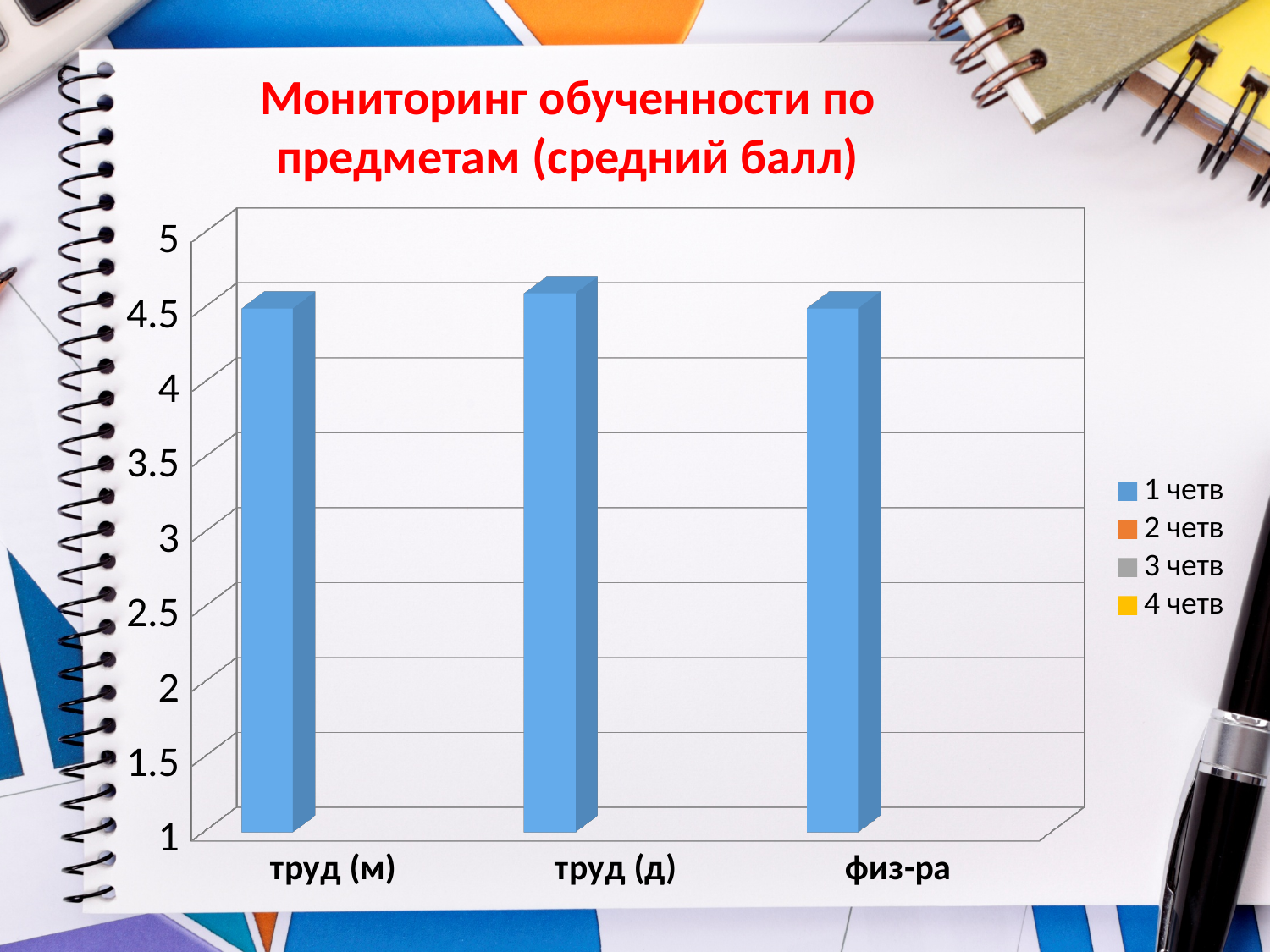
Is the value for труд (м) greater or less than 4? greater Which category has the highest bar? труд (д) Which legend entry do the plotted bars belong to? 1 четв What is the lowest value shown on the vertical axis? 1 Is the value for труд (д) greater or less than 3? greater Is the value for труд (д) greater or less than 5? less How many series does the legend list? 4 How many categories are shown on the x axis of the chart? 3 Which is larger, the value for труд (д) or the value for труд (м)? труд (д) What kind of chart is shown on the slide? bar chart What is the title of the chart? Мониторинг обученности по предметам (средний балл)